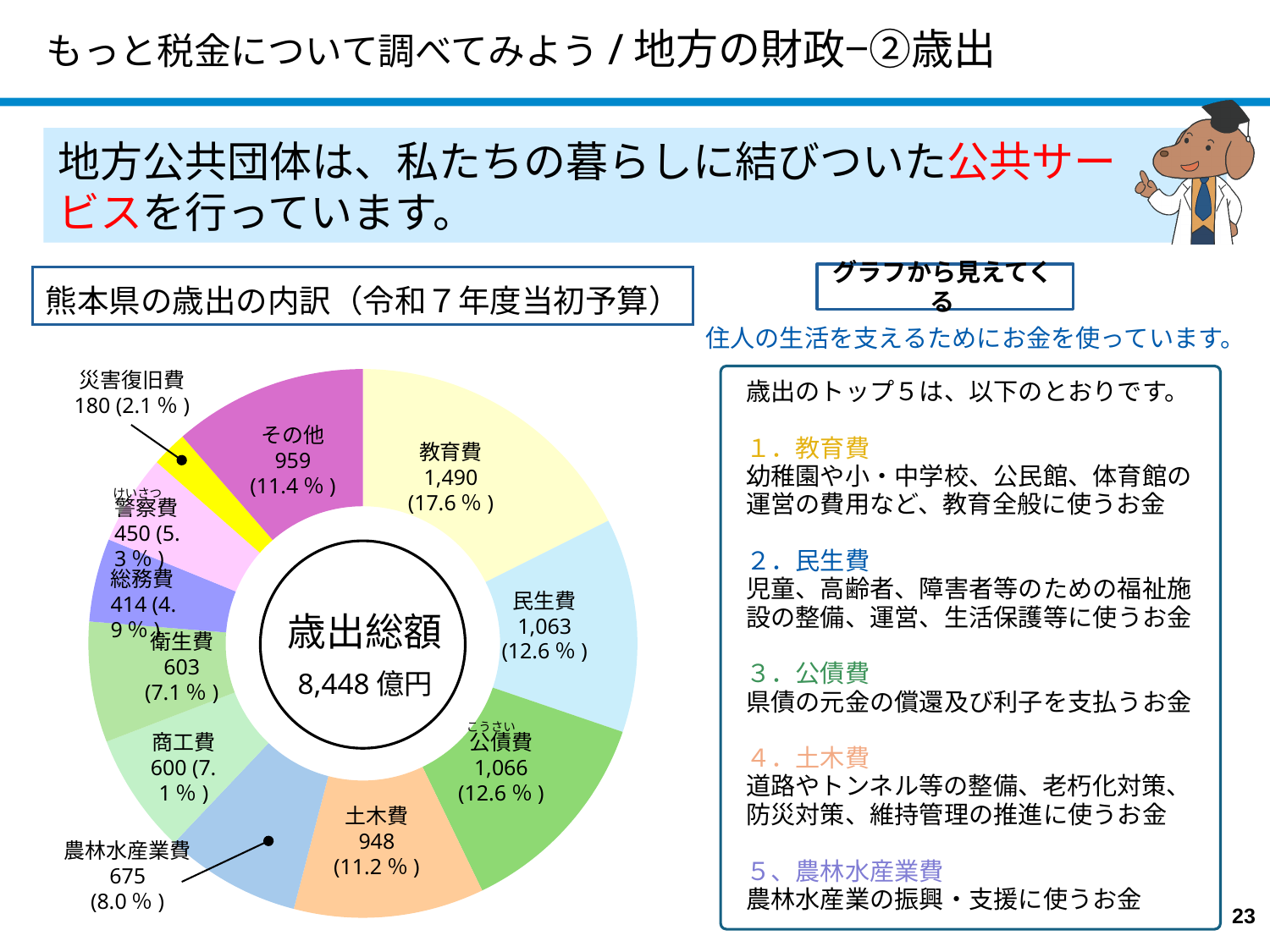
Which category has the smallest slice in the pie chart? 災害復旧費 Which category has the largest slice in the pie chart? 教育費 What percentage share does その他 have in the pie chart? 11.4 % What is the difference between the values for 教育費 and 民生費? 427 What is the title of the chart on the slide? 熊本県の歳出の内訳（令和７年度当初予算） What total expenditure (歳出総額) is shown in the centre of the chart? 8,448 億円 How many categories are shown in the pie chart? 11 What kind of chart is shown on the slide? Pie (donut) chart What is the value shown for 教育費 in the pie chart? 1,490 What percentage share does 土木費 have in the pie chart? 11.2 % Which is larger, the value for 公債費 or the value for 民生費? 公債費 What is the value shown for 農林水産業費? 675